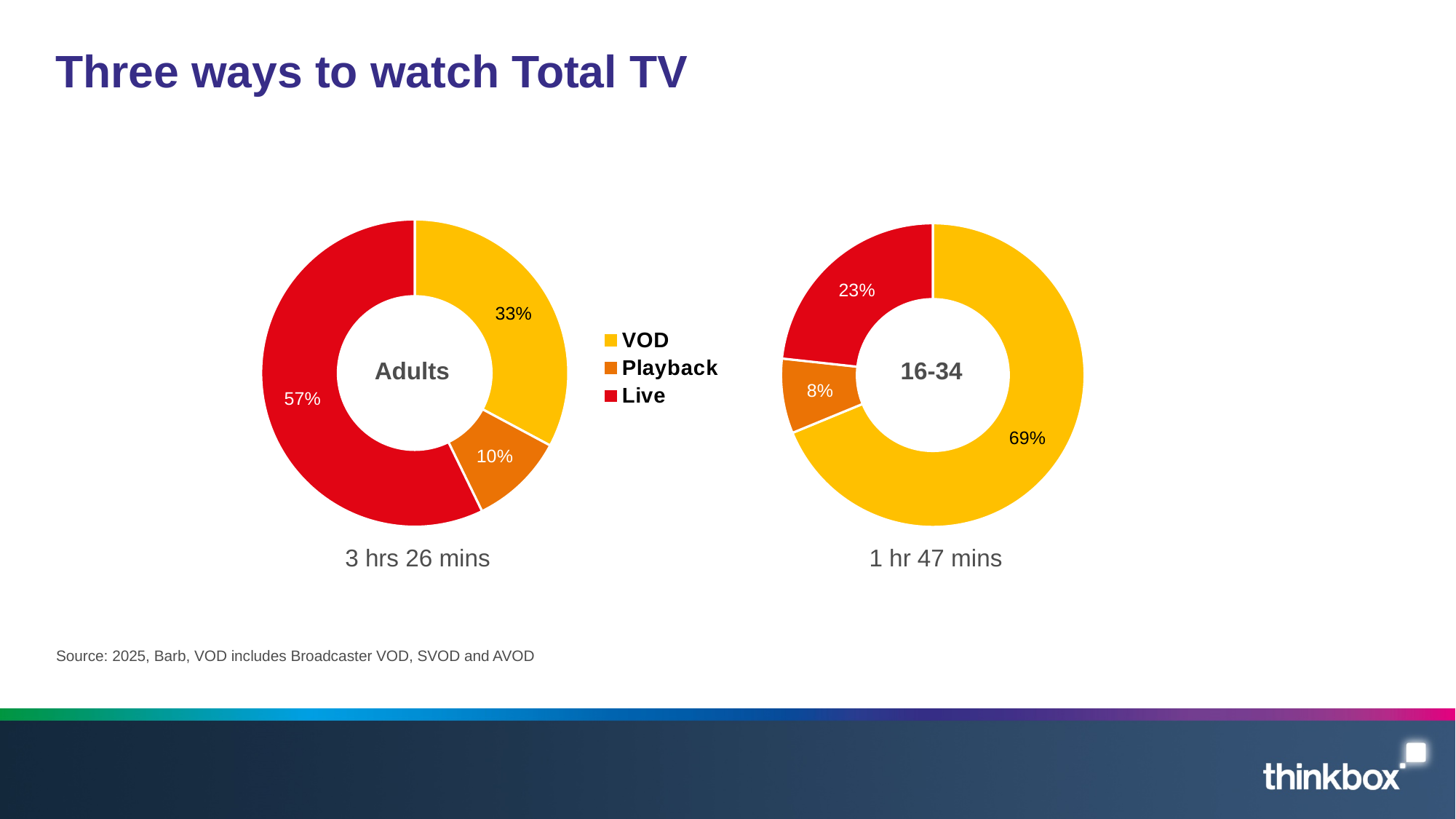
In the Adults chart, what share of viewing is Live? 57% In the 16-34 chart, what share of viewing is Live? 23% In the Adults chart, what share of viewing is Playback? 10% In the 16-34 chart, what is the difference between the VOD share and the Live share? 46 percentage points How many categories does the legend list? 3 What total viewing time is shown beneath the Adults chart? 3 hrs 26 mins In the Adults chart, which category has the largest share? Live In the 16-34 chart, what share of viewing is VOD? 69% What kind of chart is used on this slide? Pie (doughnut) chart In the 16-34 chart, which category has the smallest share? Playback In the Adults chart, what is the difference between the Live share and the VOD share? 24 percentage points Is the VOD share larger in the Adults chart or the 16-34 chart? 16-34